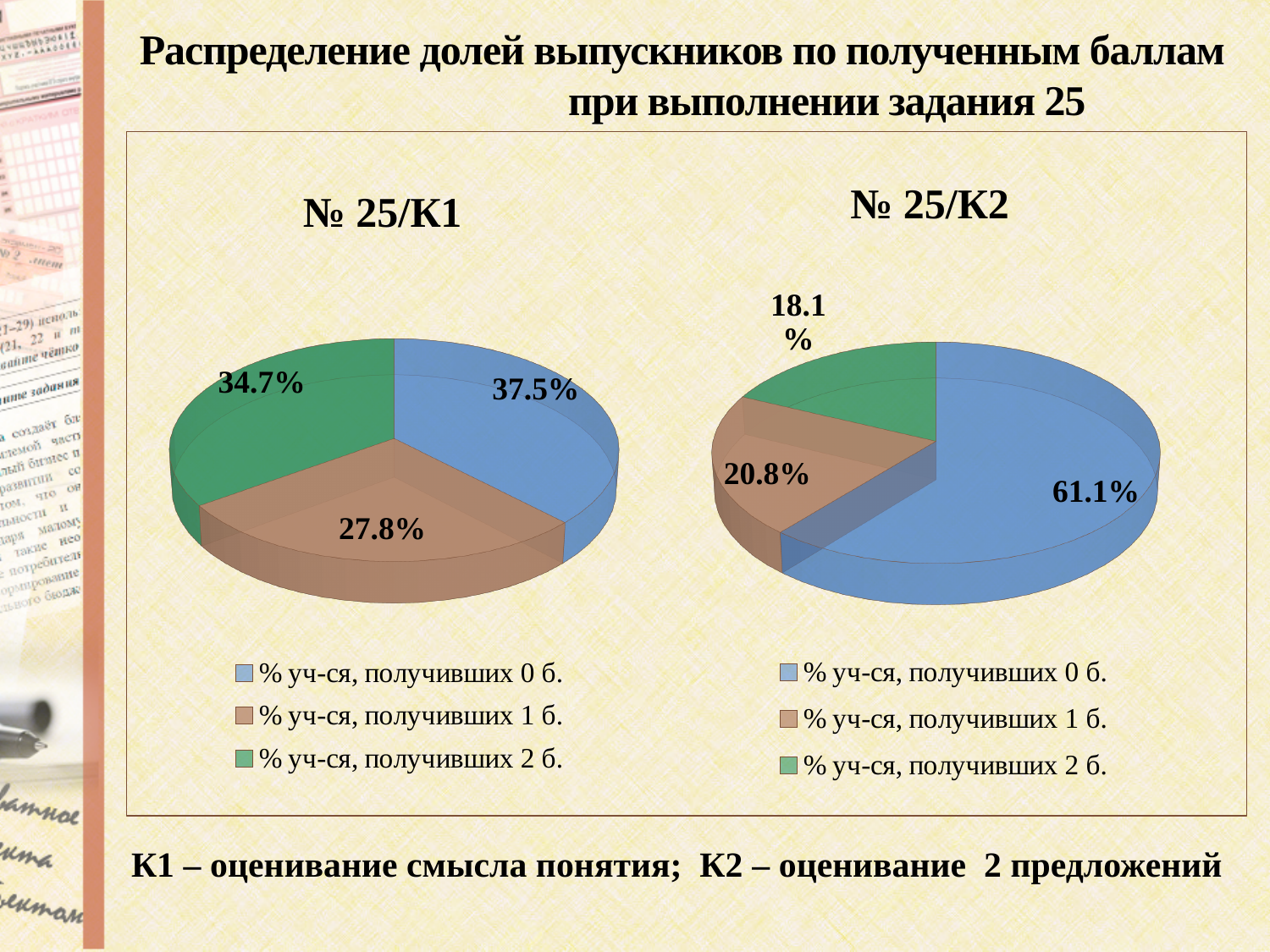
In the № 25/К1 chart, what share of students received 0 points (% уч-ся, получивших 0 б.)? 37.5% What type of chart is № 25/К1? Pie chart In the № 25/К2 chart, what share of students received 0 points (% уч-ся, получивших 0 б.)? 61.1% How many slices does the № 25/К2 chart have? 3 In the № 25/К2 chart, what share of students received 2 points (% уч-ся, получивших 2 б.)? 18.1% In the № 25/К2 chart, which category has the smallest slice? % уч-ся, получивших 2 б. In the № 25/К1 chart, what is the difference between the share of students with 0 points and the share with 1 point? 9.7% Which chart has the larger share of students receiving 2 points, № 25/К1 or № 25/К2? № 25/К1 In the № 25/К1 chart, which category has the largest slice? % уч-ся, получивших 0 б. In the № 25/К1 chart, which colour represents students who received 2 points? Green In the № 25/К1 chart, what share of students received 1 point (% уч-ся, получивших 1 б.)? 27.8% In the № 25/К2 chart, what is the difference between the share of students with 0 points and the share with 1 point? 40.3%